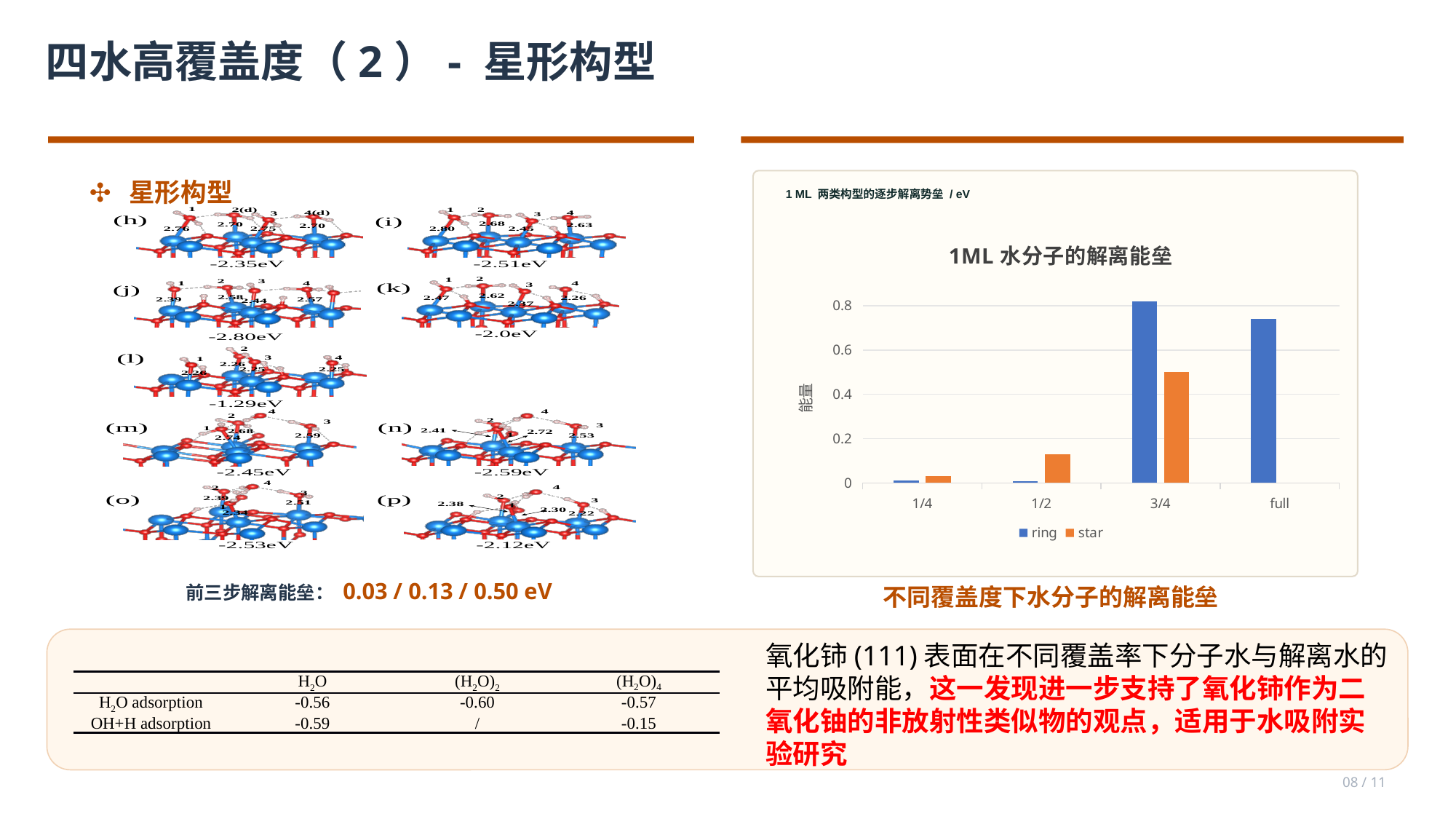
In the bar chart, is the ring value at full coverage greater or less than 0.8? less In the bar chart, is the ring value at 3/4 coverage greater or less than 0.6? greater In the bar chart, is the star value at 1/2 coverage greater or less than 0.2? less How many coverage categories are shown on the x axis of the bar chart? 4 In the bar chart, which series has the larger value at 3/4 coverage, ring or star? ring What kind of chart is shown on the right side of the slide? bar chart How many series does the legend of the bar chart list? 2 What is the title of the bar chart? 1ML 水分子的解离能垒 In the bar chart, which series has the larger value at 1/2 coverage, ring or star? star In the bar chart, at which coverage is the ring series highest? 3/4 In the bar chart, at which coverage is the star series highest? 3/4